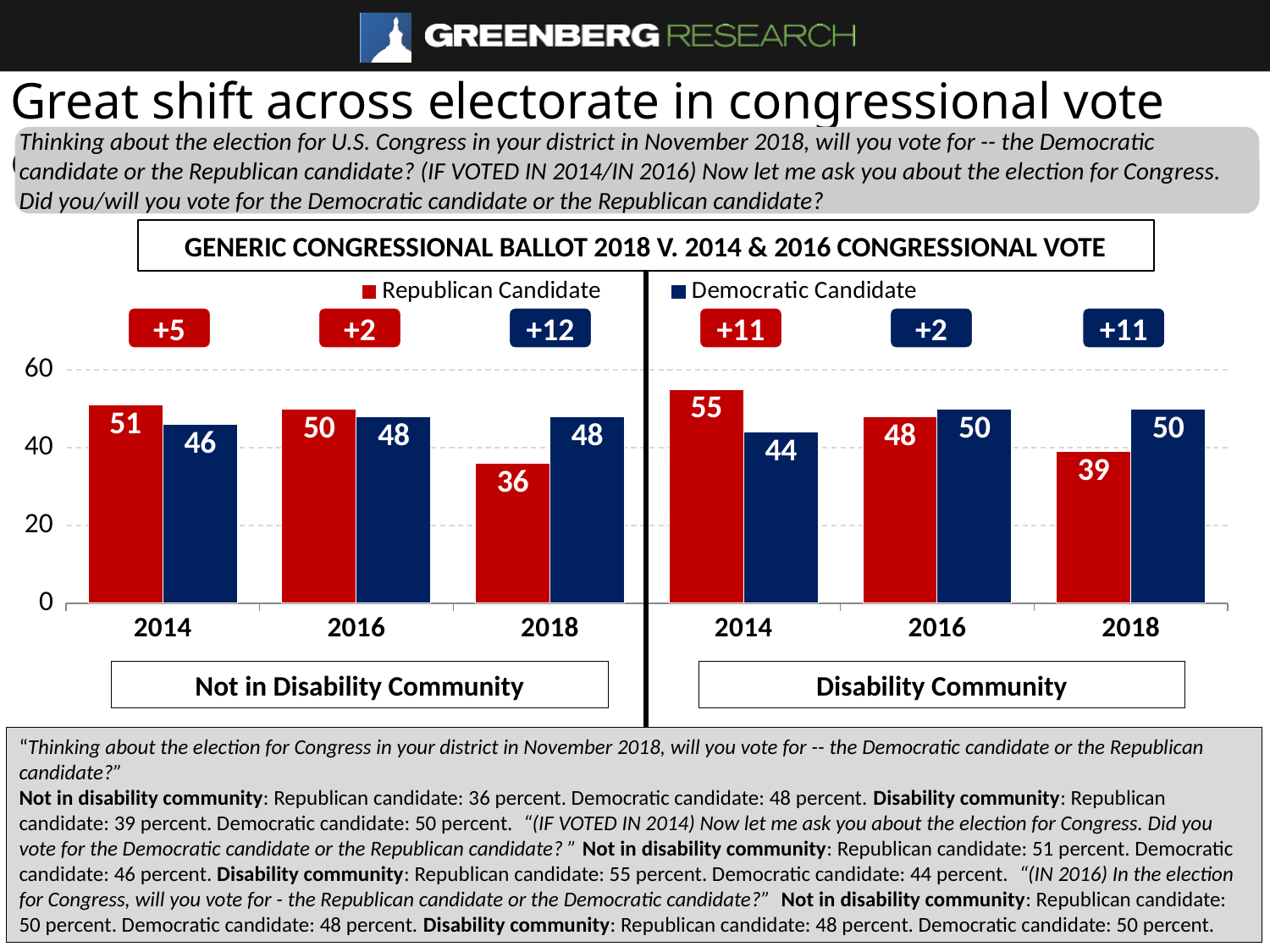
In the Disability Community panel, which is larger in 2014: the Republican Candidate or the Democratic Candidate? Republican Candidate In the Not in Disability Community panel, does the Republican Candidate value rise or fall from 2014 to 2018? fall In the Disability Community panel, is the value for the Republican Candidate in 2018 greater or less than 40? less In the Disability Community panel, what is the value for the Republican Candidate in 2016? 48 Across both panels, which bar has the lowest value? Republican Candidate, 2018, Not in Disability Community (36) In the Disability Community panel, what is the value for the Democratic Candidate in 2014? 44 Across both panels, which bar has the highest value? Republican Candidate, 2014, Disability Community (55) What colour represents the Democratic Candidate in the chart? dark blue What kind of chart is shown on the slide? bar chart In the Not in Disability Community panel, what is the value for the Republican Candidate in 2018? 36 How many series does the legend list? 2 In the Not in Disability Community panel, what is the difference between the Democratic Candidate and the Republican Candidate in 2018? 12